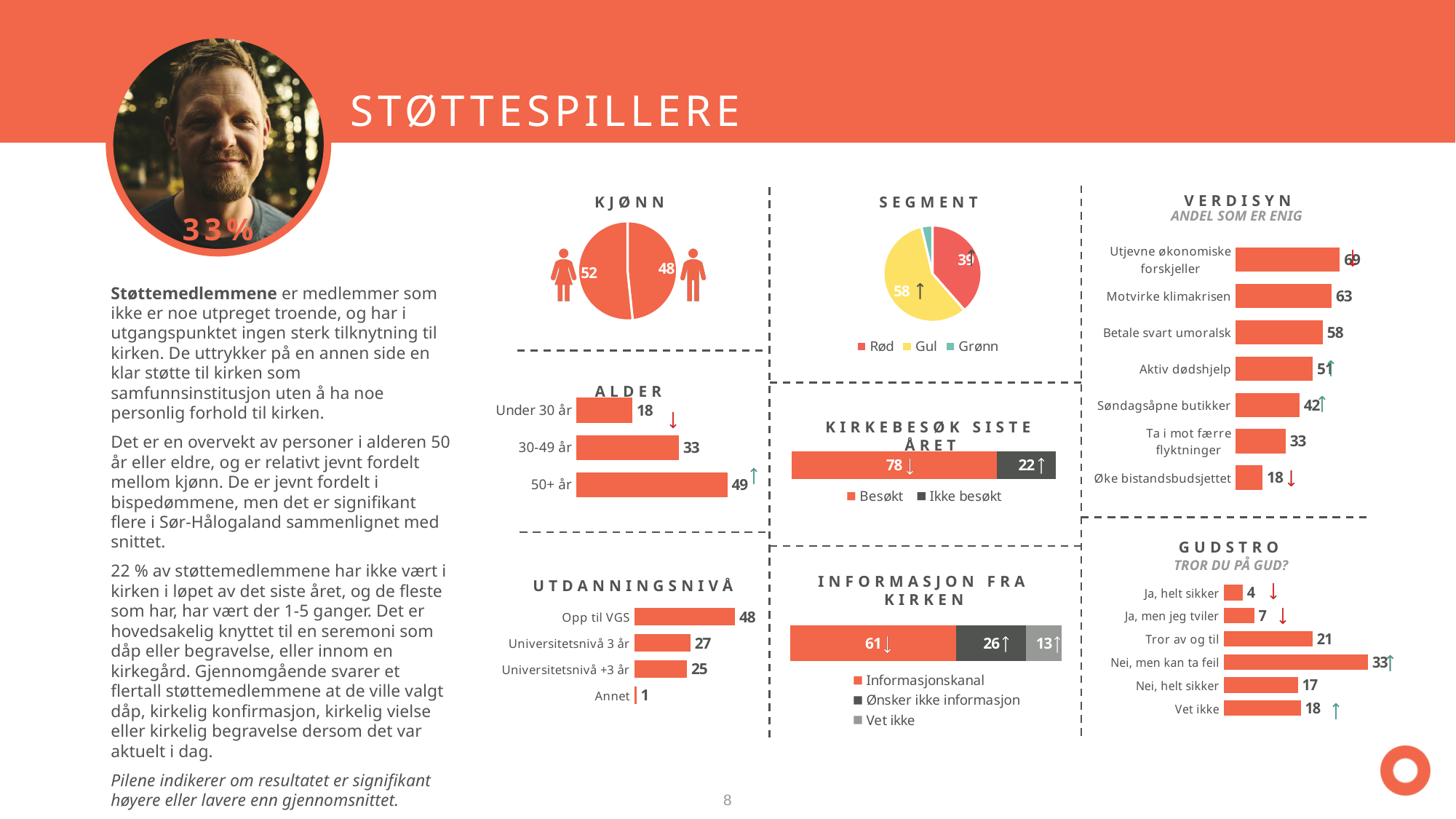
In the ALDER chart, what is the value for 50+ år? 49 In the SEGMENT pie chart, what is the value for Gul? 58 In the INFORMASJON FRA KIRKEN chart, what is the total of the stacked bar? 100 In the VERDISYN chart, what is the value for Motvirke klimakrisen? 63 In the KIRKEBESØK SISTE ÅRET chart, what is the value for Ikke besøkt? 22 In the UTDANNINGSNIVÅ chart, what is the difference between Universitetsnivå 3 år and Universitetsnivå +3 år? 2 How many categories does the UTDANNINGSNIVÅ chart show? 4 How many entries does the legend of the SEGMENT pie chart list? 3 In the UTDANNINGSNIVÅ chart, what is the value for Opp til VGS? 48 In the ALDER chart, which age group has the lowest value? Under 30 år In the GUDSTRO chart, which category has the highest value? Nei, men kan ta feil In the KJØNN pie chart, what is the value for the female segment? 52